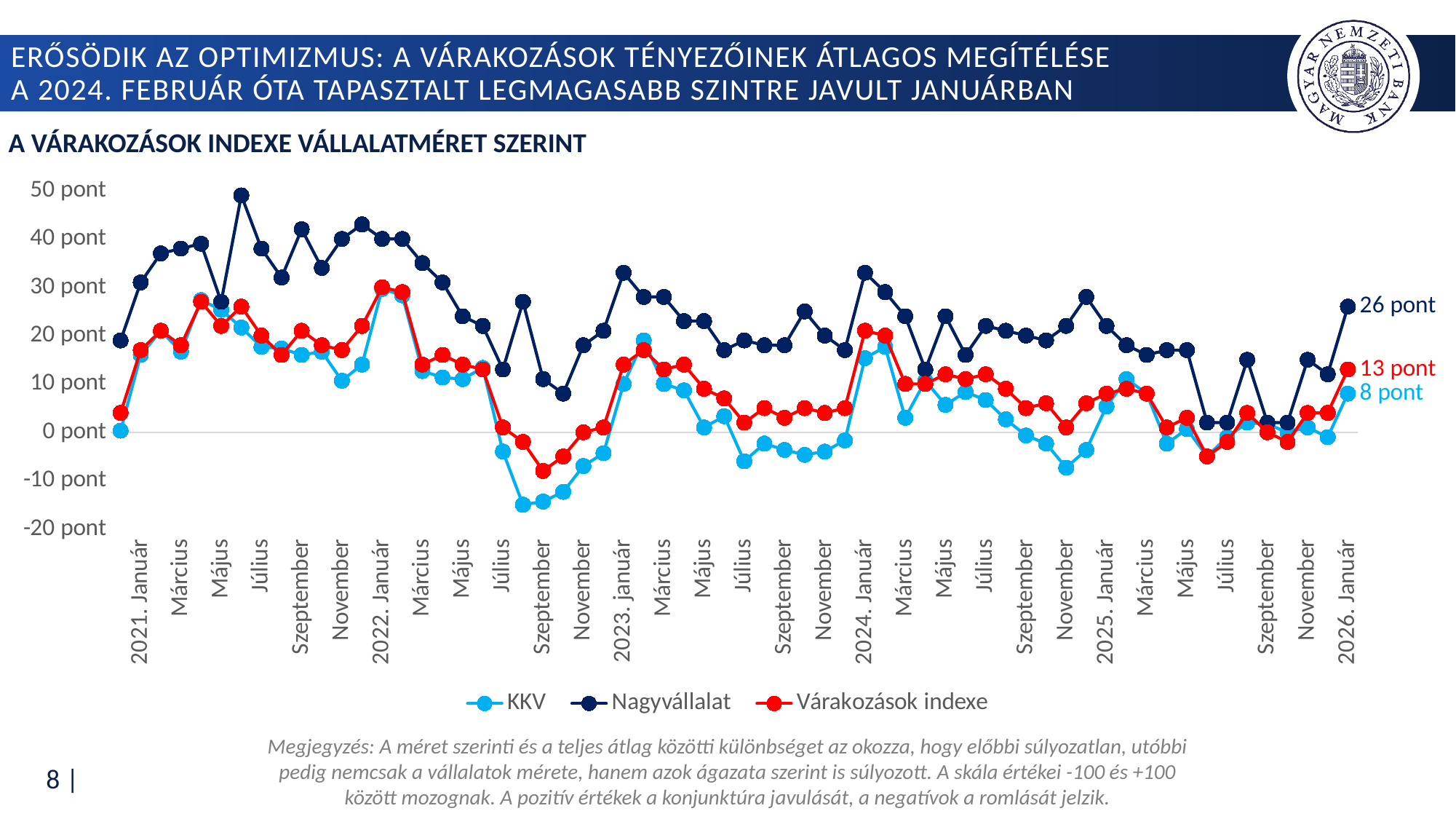
What is the value for KKV in 2026. Január? 8 pont What is the value for Várakozások indexe in 2026. Január? 13 pont Is the value for KKV in 2022 Szeptember greater or less than 0 pont? less Is the value for Nagyvállalat in 2021. Január greater or less than 10 pont? greater Which series has the highest value in 2026. Január? Nagyvállalat What is the title of the chart? A VÁRAKOZÁSOK INDEXE VÁLLALATMÉRET SZERINT What is the difference between the Nagyvállalat and KKV values in 2026. Január? 18 pont Which is larger in 2026. Január, the KKV value or the Várakozások indexe value? Várakozások indexe What kind of chart is shown on the slide? Line chart What is the value for Nagyvállalat in 2026. Január? 26 pont How many series does the legend list? 3 What is the difference between the Nagyvállalat and Várakozások indexe values in 2026. Január? 13 pont